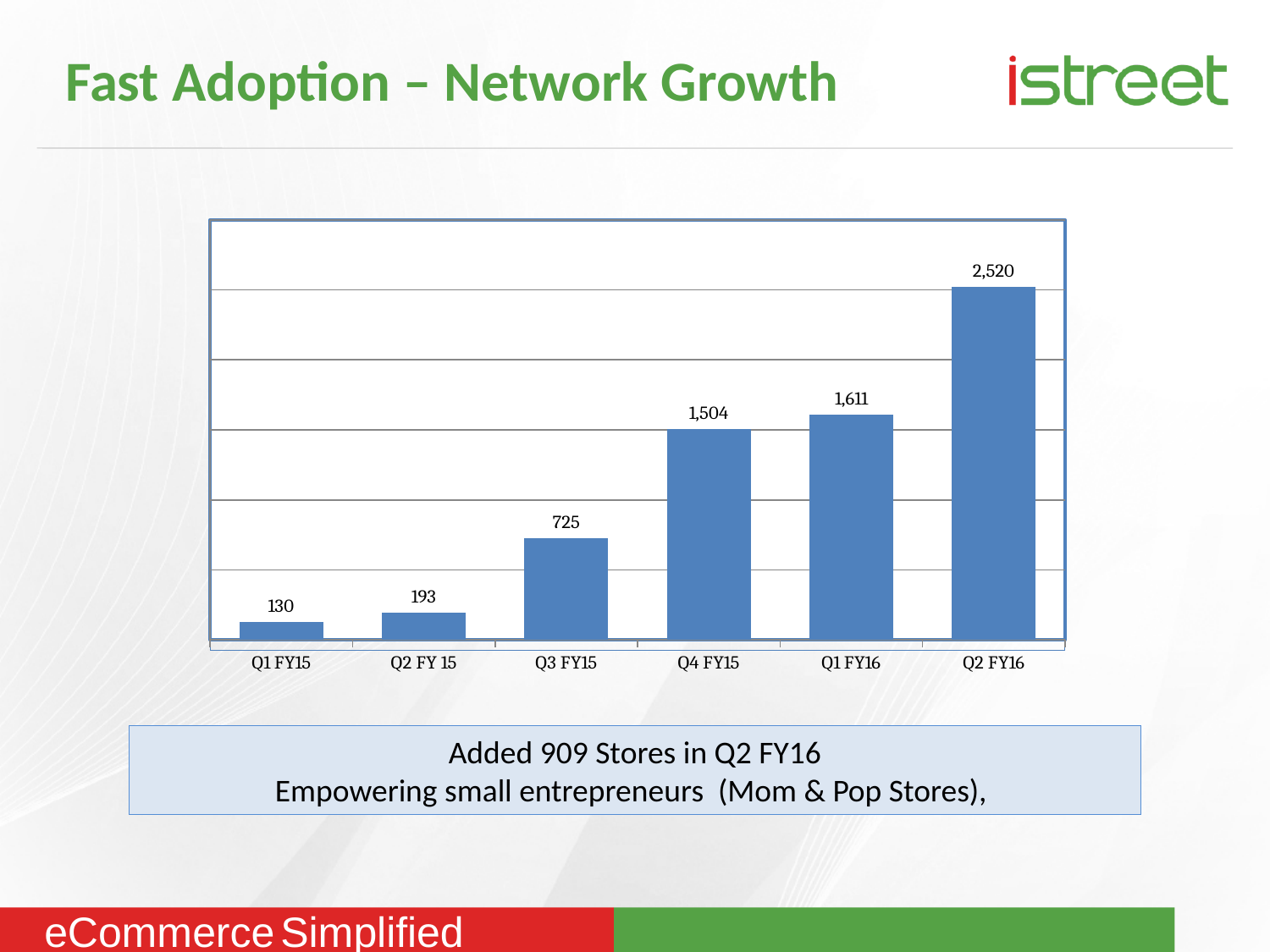
What is the value for Q1 FY15? 130 What kind of chart is shown on the slide? Bar chart Do the values rise or fall from Q1 FY15 to Q2 FY16? Rise Which is larger, the value for Q2 FY 15 or the value for Q3 FY15? Q3 FY15 What is the difference between the values for Q4 FY15 and Q3 FY15? 779 What is the difference between the values for Q2 FY16 and Q1 FY16? 909 What is the value for Q2 FY16? 2,520 What is the value for Q3 FY15? 725 How many quarters are shown on the x axis? 6 Which quarter has the highest value? Q2 FY16 What is the value for Q1 FY16? 1,611 Which quarter has the lowest value? Q1 FY15